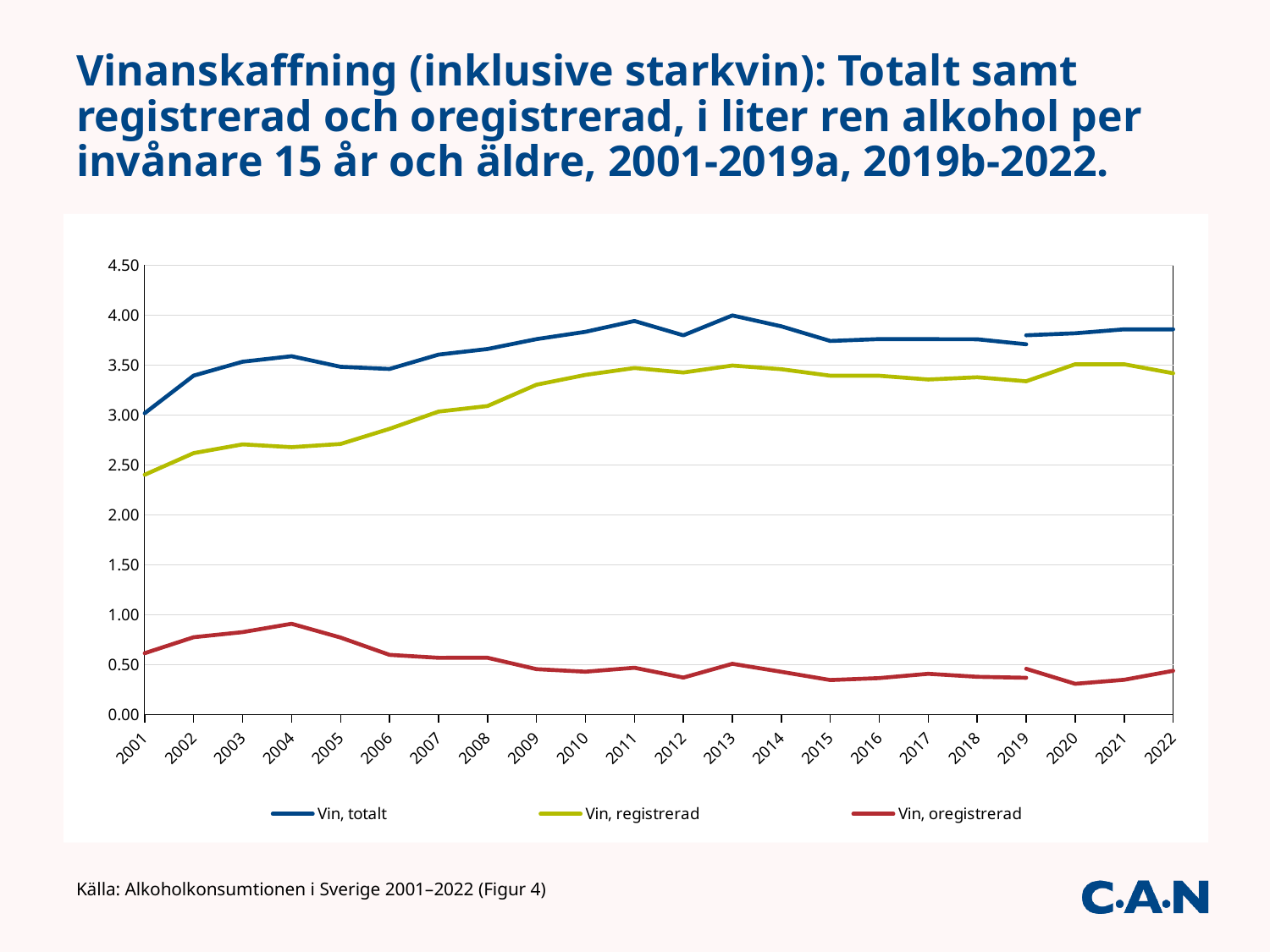
Is the value for Vin, oregistrerad in 2004 greater or less than 1.00? less What colour is the line for Vin, totalt? Blue In which year is the value for Vin, oregistrerad highest? 2004 Does the value for Vin, oregistrerad rise or fall from 2004 to 2015? Fall Is the value for Vin, totalt in 2013 greater or less than 3.50? greater In which year is the value for Vin, totalt lowest? 2001 What kind of chart is shown on the slide? Line chart How many series does the legend list? 3 How many years are labelled on the x axis? 22 Which series has the larger value in 2010, Vin, totalt or Vin, oregistrerad? Vin, totalt In which year is the value for Vin, registrerad lowest? 2001 Is the value for Vin, registrerad in 2001 greater or less than 2.50? less